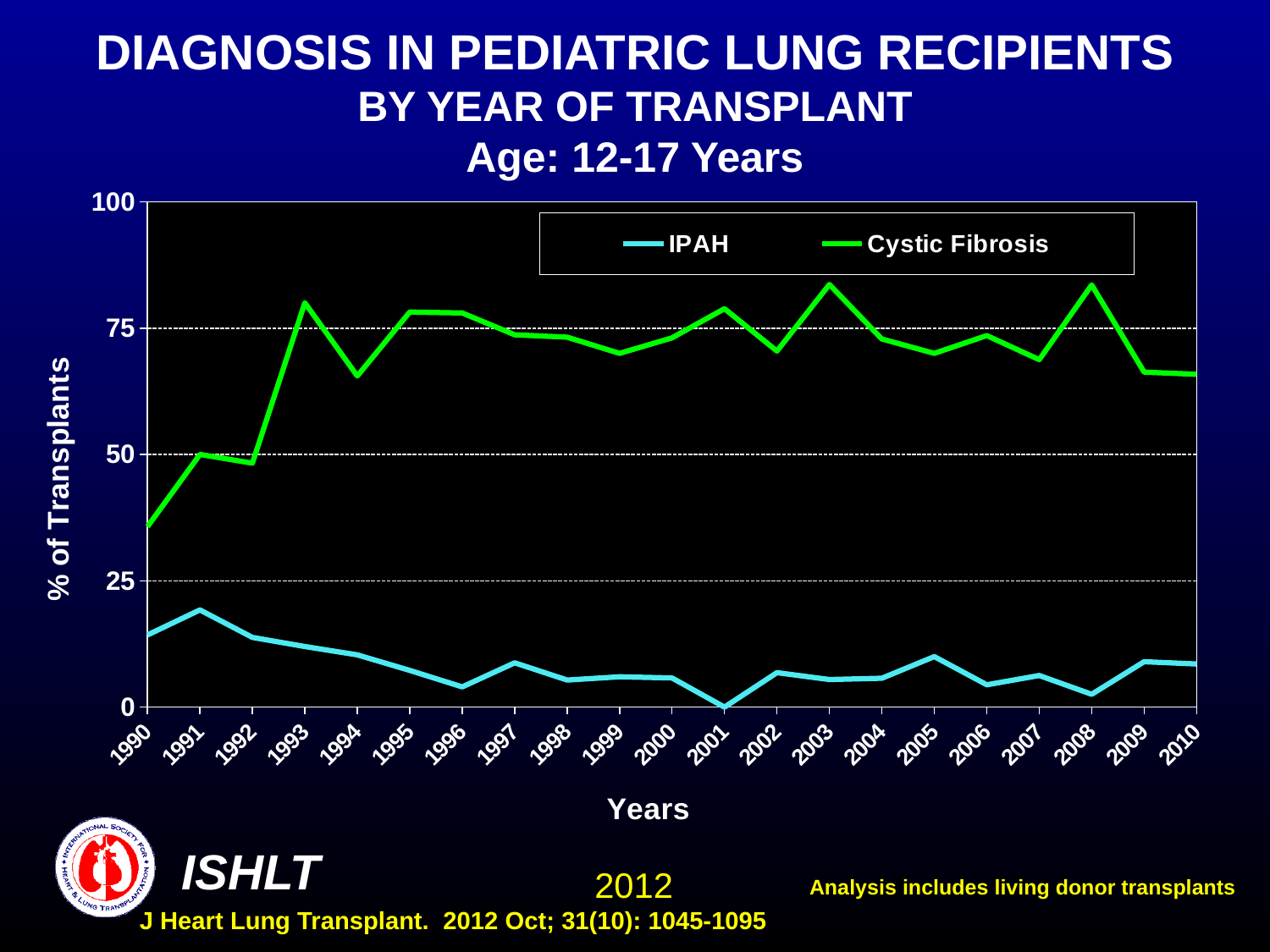
Does the Cystic Fibrosis line rise or fall from 1990 to 1993? rise Is the IPAH value for 1991 greater or less than 25? less In which year is the IPAH value highest? 1991 Which series has the larger value in 2000, IPAH or Cystic Fibrosis? Cystic Fibrosis In which year is the Cystic Fibrosis value lowest? 1990 Is the Cystic Fibrosis value for 1990 greater or less than 50? less In which year is the IPAH value lowest? 2001 What kind of chart is shown on the slide? line chart How many years are plotted along the x axis? 21 Is the Cystic Fibrosis value for 1994 greater or less than 75? less How many series does the legend list? 2